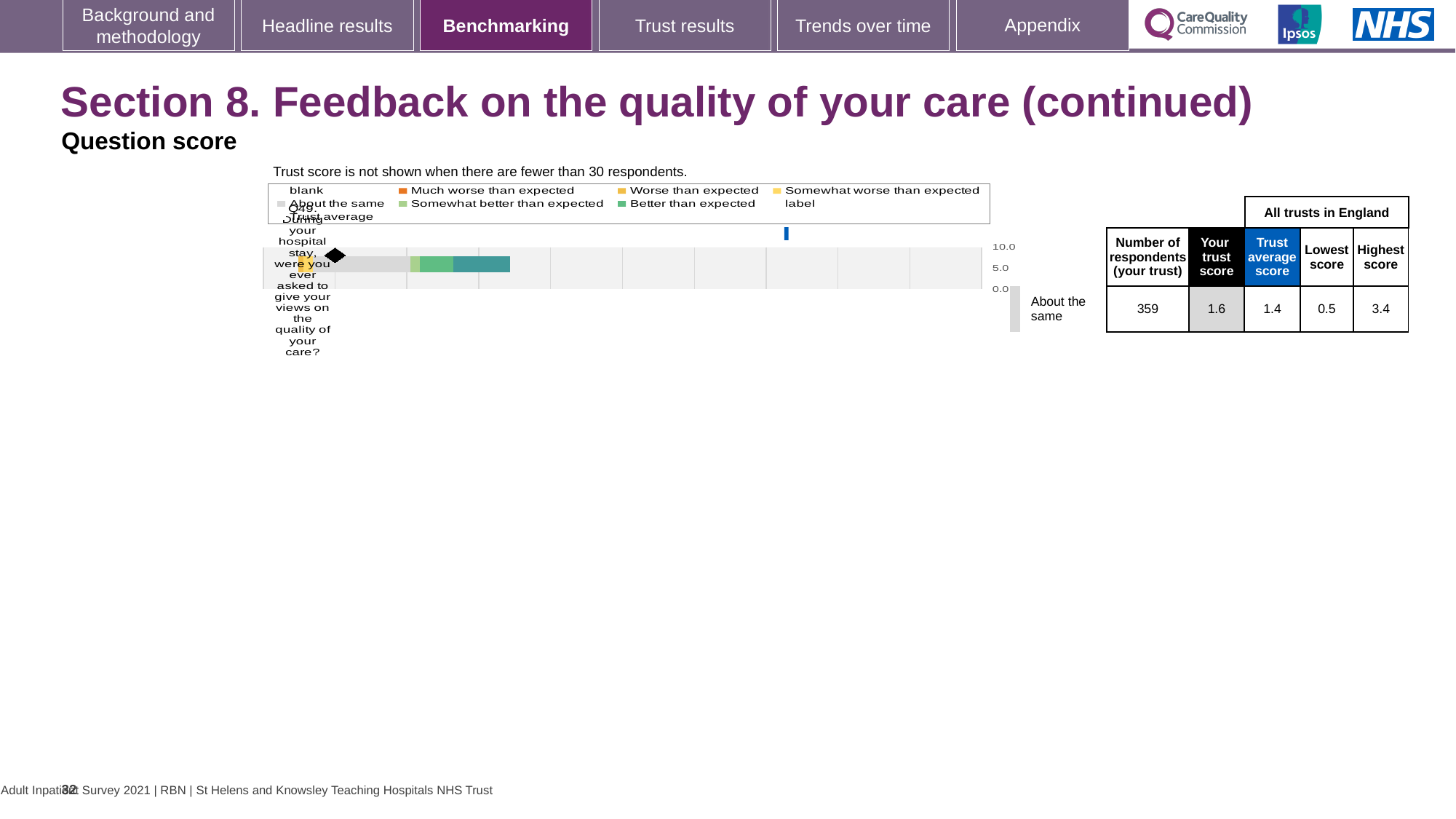
What is the difference between the highest score and the lowest score for Q49? 2.9 Which benchmark category is the trust's result for Q49 placed in? About the same How many questions (categories) are plotted on the chart? 1 How many respondents from the trust answered Q49? 359 What is the highest score among all trusts in England for Q49? 3.4 Which is larger for Q49, the trust score or the trust average score? trust score Is the trust score for Q49 greater or less than 5.0? less What is the lowest score among all trusts in England for Q49? 0.5 What is the trust average score for Q49? 1.4 What is the difference between the trust score and the trust average score for Q49? 0.2 What kind of chart is used to show the benchmarking result for Q49? bar chart What is the trust score for Q49 (During your hospital stay, were you ever asked to give your views on the quality of your care?)? 1.6